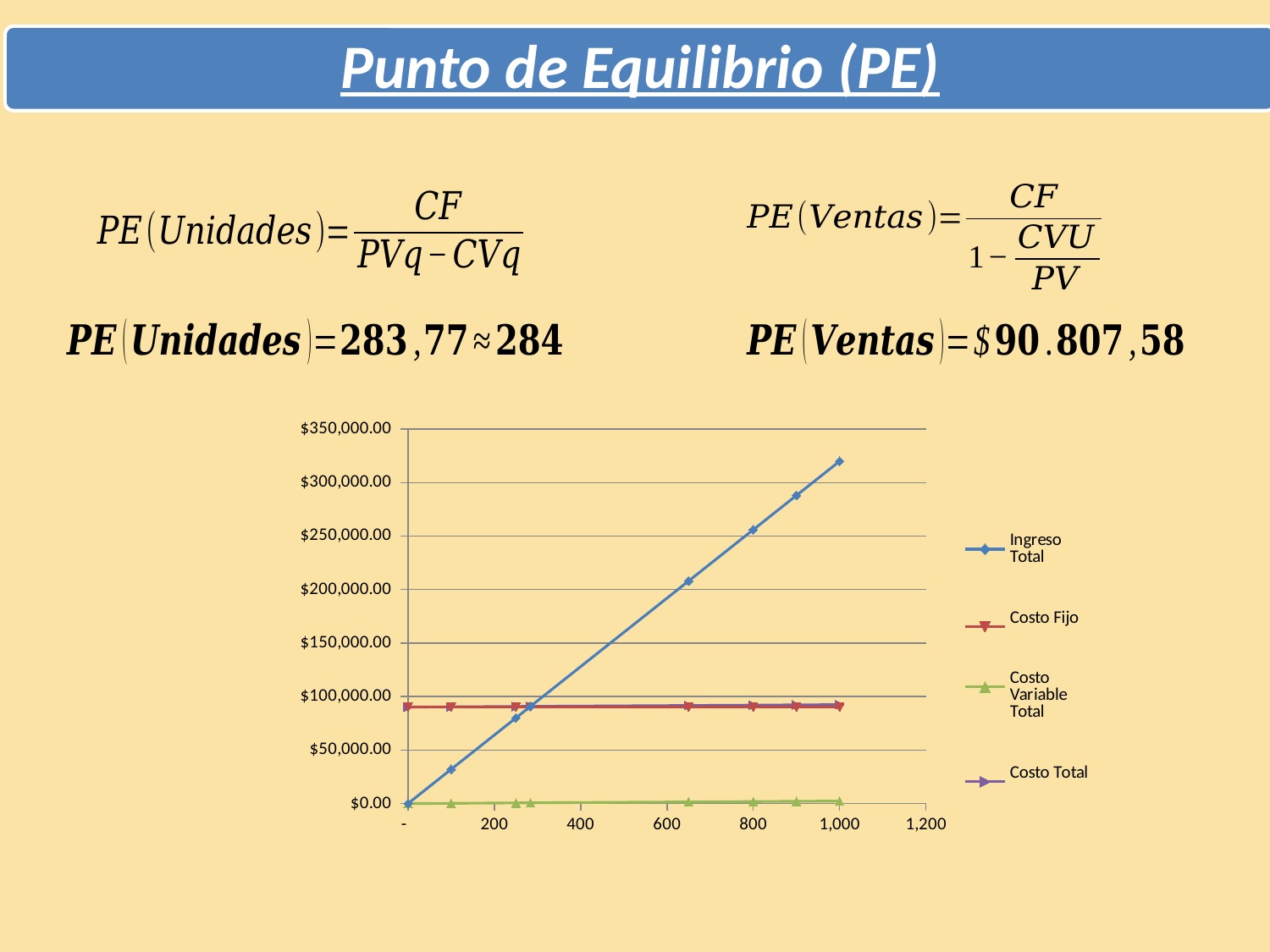
Which series has the highest value at 1,000 units? Ingreso Total Is the value of Costo Fijo greater or less than $100,000.00? less Is the value of Ingreso Total at 200 units greater or less than $100,000.00? less At 1,000 units, which is larger: Ingreso Total or Costo Total? Ingreso Total Does the Ingreso Total series rise or fall as the x-axis values increase? rise How many series does the chart legend list? 4 What kind of chart is shown on the slide? line chart At 200 units, which is larger: Costo Fijo or Ingreso Total? Costo Fijo Which series are listed in the chart legend? Ingreso Total, Costo Fijo, Costo Variable Total, Costo Total Which series has the lowest value at 1,000 units? Costo Variable Total Is the value of Costo Variable Total at 1,000 units greater or less than $50,000.00? less